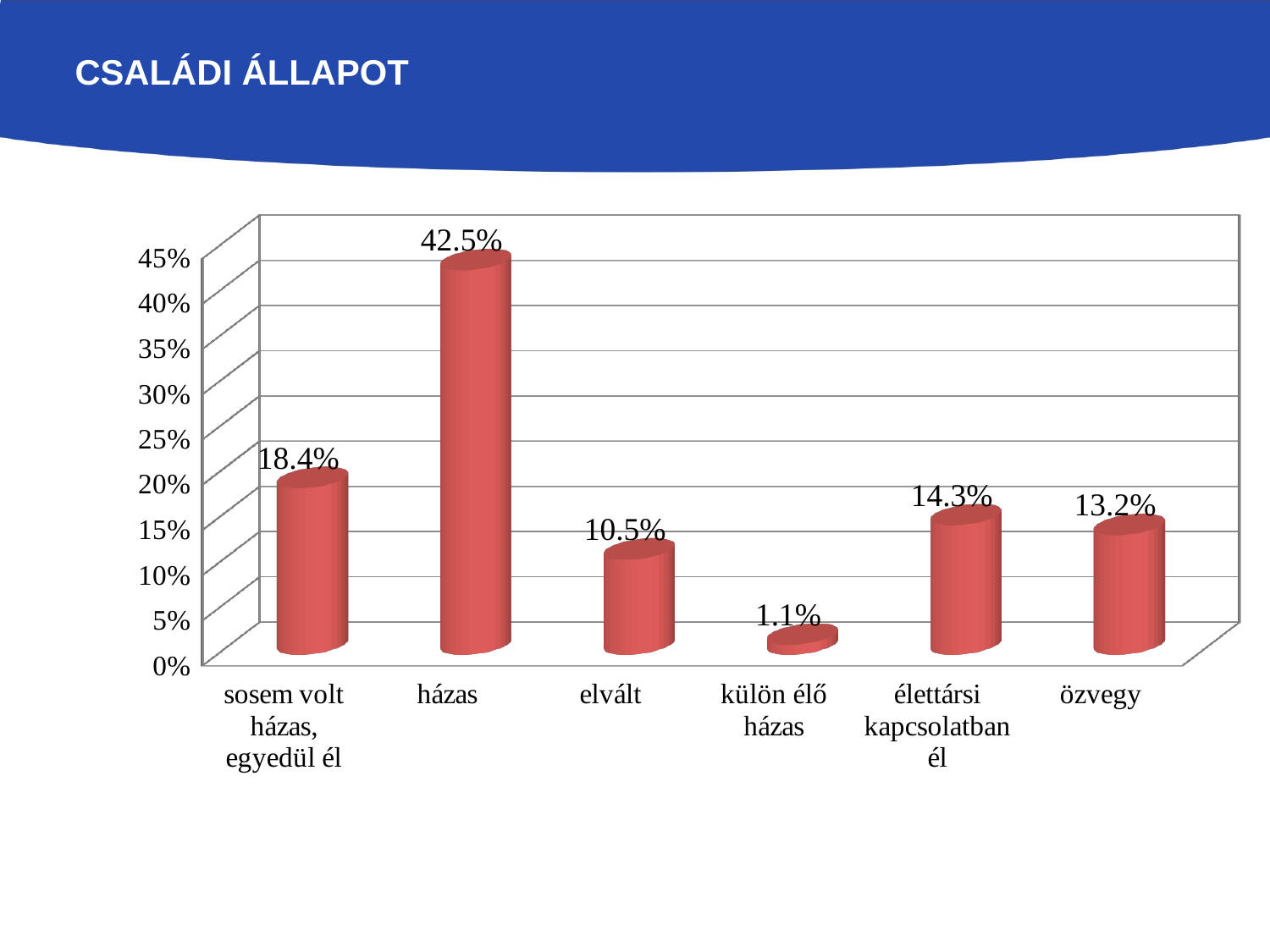
Which category has the highest value? házas What is the title of the slide containing the chart? CSALÁDI ÁLLAPOT What is the difference between the values for "házas" and "elvált"? 32 percentage points What kind of chart is shown on the slide? bar chart Which is larger, the value for "élettársi kapcsolatban él" or the value for "özvegy"? élettársi kapcsolatban él What is the value for "élettársi kapcsolatban él"? 14.3% What is the value for "házas"? 42.5% How many categories are shown on the x axis? 6 What is the value for "sosem volt házas, egyedül él"? 18.4% Is the value for "sosem volt házas, egyedül él" greater or less than 20%? less What is the value for "özvegy"? 13.2% Which category has the lowest value? külön élő házas